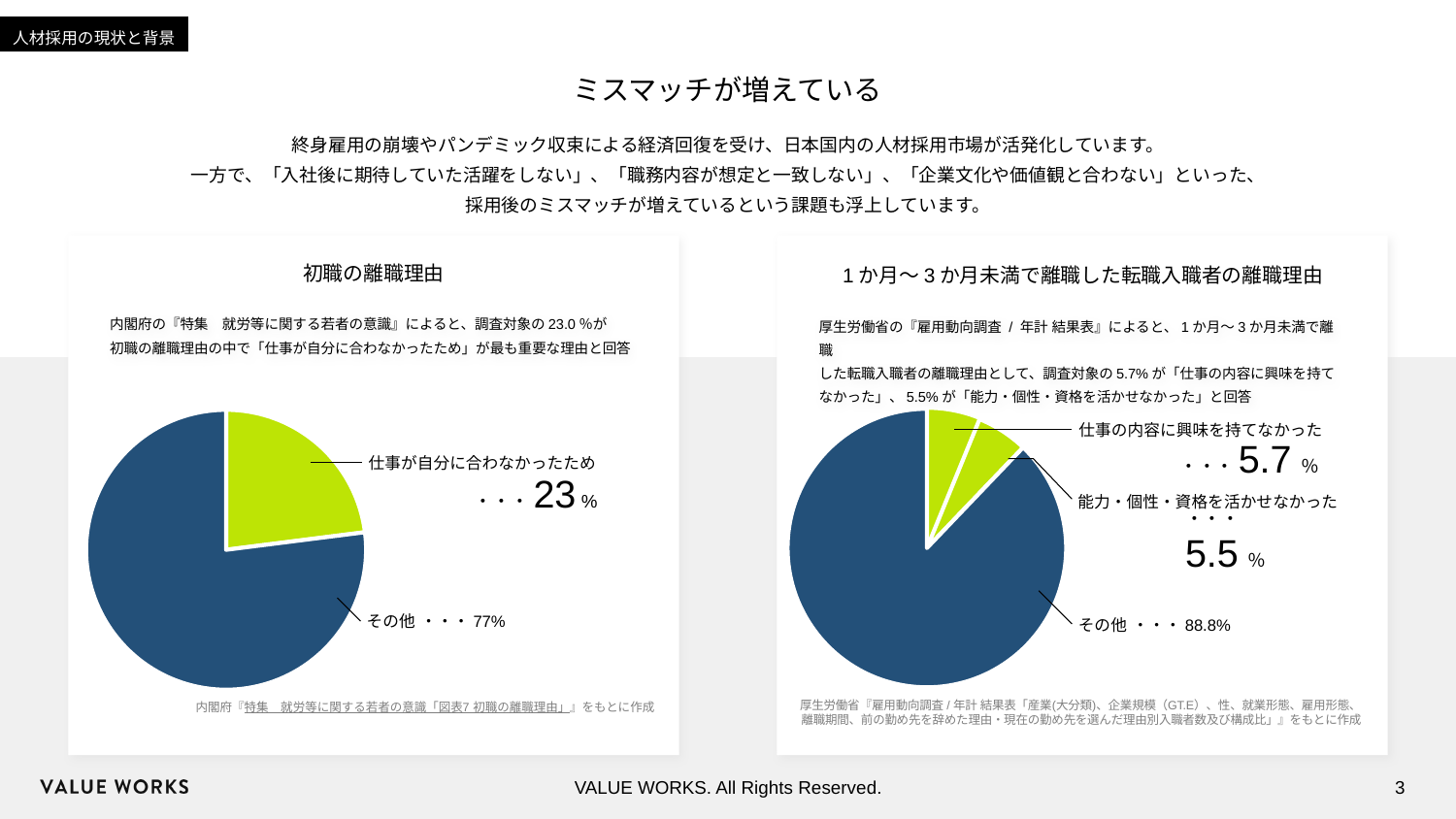
In the right chart titled 「1か月～3か月未満で離職した転職入職者の離職理由」, what percentage is shown for 「その他」? 88.8% In the right chart titled 「1か月～3か月未満で離職した転職入職者の離職理由」, what percentage is shown for 「能力・個性・資格を活かせなかった」? 5.5% In the right chart titled 「1か月～3か月未満で離職した転職入職者の離職理由」, what percentage is shown for 「仕事の内容に興味を持てなかった」? 5.7% In the right chart titled 「1か月～3か月未満で離職した転職入職者の離職理由」, which is larger: 「仕事の内容に興味を持てなかった」 or 「能力・個性・資格を活かせなかった」? 仕事の内容に興味を持てなかった In the right chart titled 「1か月～3か月未満で離職した転職入職者の離職理由」, what is the difference between 「仕事の内容に興味を持てなかった」 and 「能力・個性・資格を活かせなかった」? 0.2% In the left chart titled 「初職の離職理由」, what percentage is shown for 「その他」? 77% In the left chart titled 「初職の離職理由」, what is the difference between 「その他」 and 「仕事が自分に合わなかったため」? 54% How many slices does the right pie chart titled 「1か月～3か月未満で離職した転職入職者の離職理由」 have? 3 How many slices does the left pie chart titled 「初職の離職理由」 have? 2 In the left chart titled 「初職の離職理由」, which slice is the largest? その他 In the left chart titled 「初職の離職理由」, what percentage is shown for 「仕事が自分に合わなかったため」? 23% What type of chart is used in the right panel titled 「1か月～3か月未満で離職した転職入職者の離職理由」? Pie chart